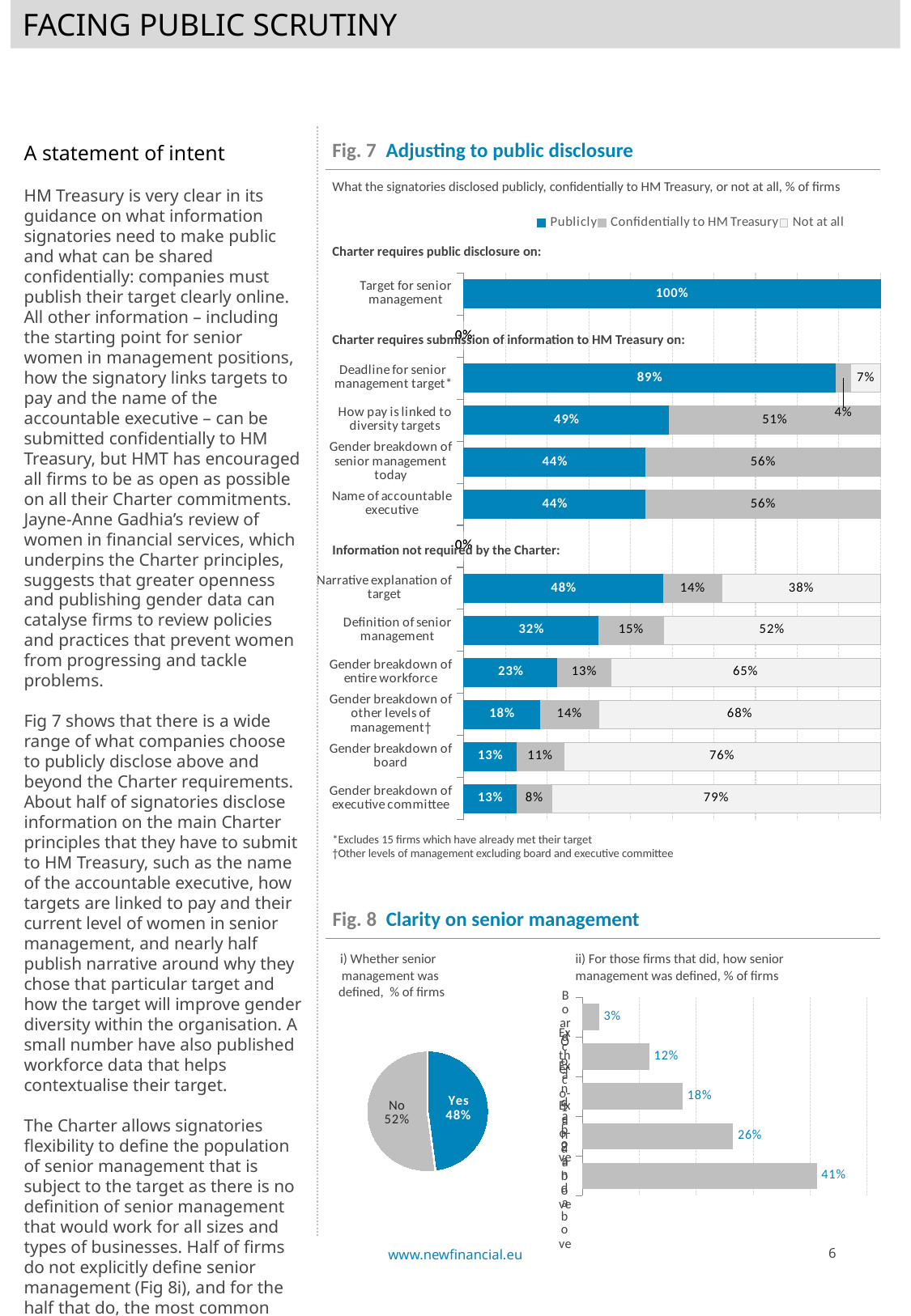
In Fig. 7 'Adjusting to public disclosure', what percentage of firms did not disclose the gender breakdown of the executive committee at all? 79% In Fig. 8 part ii (how senior management was defined), what is the highest value shown on any bar? 41% In Fig. 7 'Adjusting to public disclosure', what percentage of firms disclosed the target for senior management publicly? 100% In Fig. 7 'Adjusting to public disclosure', which was disclosed publicly by a larger share of firms: narrative explanation of target or definition of senior management? Narrative explanation of target In Fig. 7 'Adjusting to public disclosure', which item under 'Information not required by the Charter' has the highest 'Not at all' share? Gender breakdown of executive committee How many series does the legend of Fig. 7 'Adjusting to public disclosure' list? 3 In Fig. 7 'Adjusting to public disclosure', what percentage of firms disclosed how pay is linked to diversity targets confidentially to HM Treasury? 51% What kind of chart is Fig. 8 part i (whether senior management was defined)? Pie chart In Fig. 7 'Adjusting to public disclosure', what is the total of the three segments for the 'Narrative explanation of target' bar? 100% What kind of chart is Fig. 7 'Adjusting to public disclosure'? Stacked bar chart In Fig. 8 part i (whether senior management was defined), what share of the pie is 'Yes'? 48% In Fig. 7 'Adjusting to public disclosure', what is the difference in percentage points between the share disclosing the deadline for senior management target publicly and the share disclosing the name of accountable executive publicly? 45 percentage points